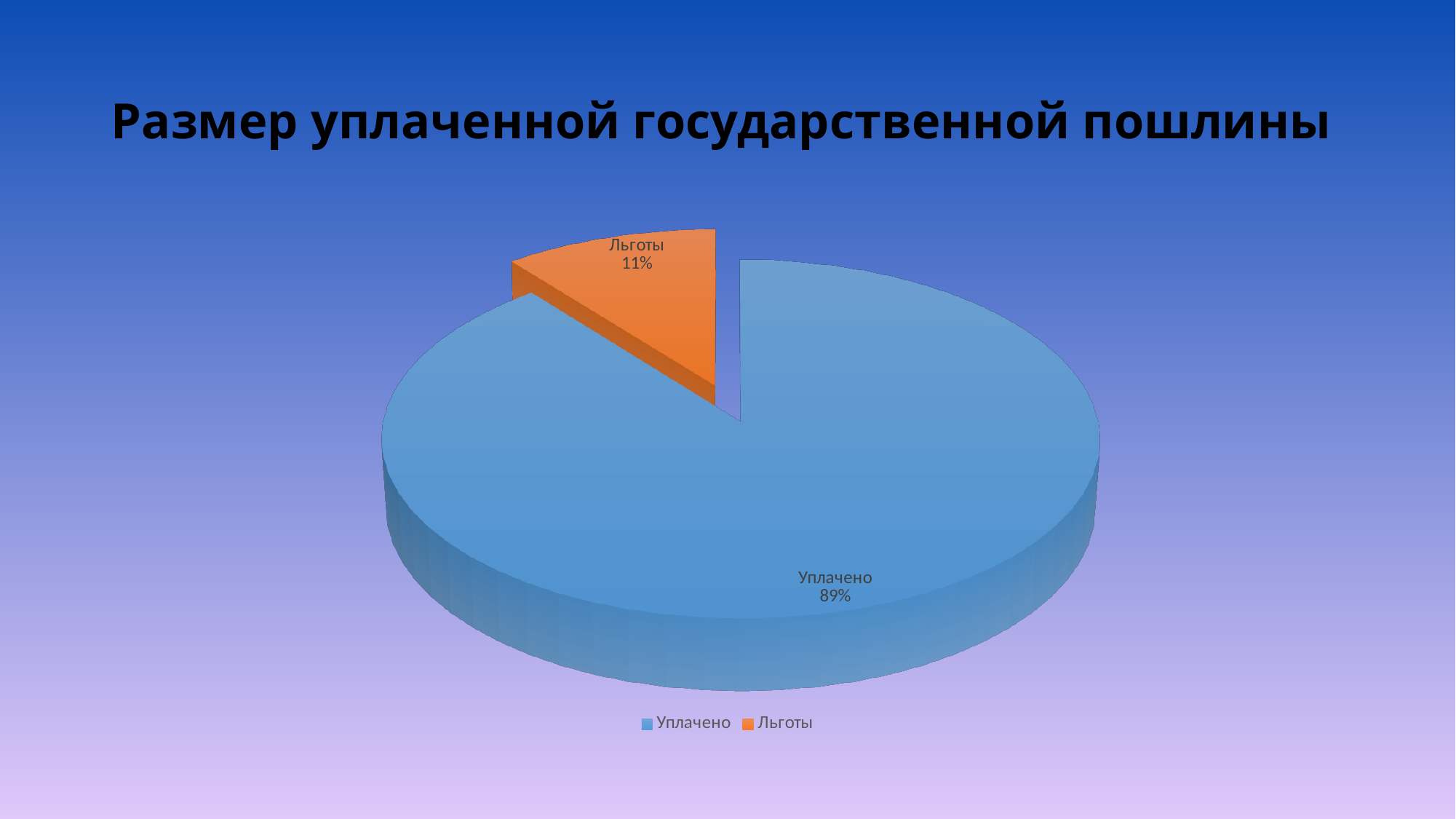
Which is larger, Уплачено or Льготы? Уплачено What colour is the Льготы slice? orange What kind of chart is shown on the slide? pie chart Which slice is the smallest? Льготы Which slice is the largest? Уплачено What is the title of the chart? Размер уплаченной государственной пошлины How many slices does the pie chart have? 2 What share of the pie does Льготы represent? 11% What share of the pie does Уплачено represent? 89% How many entries does the legend list? 2 What is the difference in percentage points between Уплачено and Льготы? 78